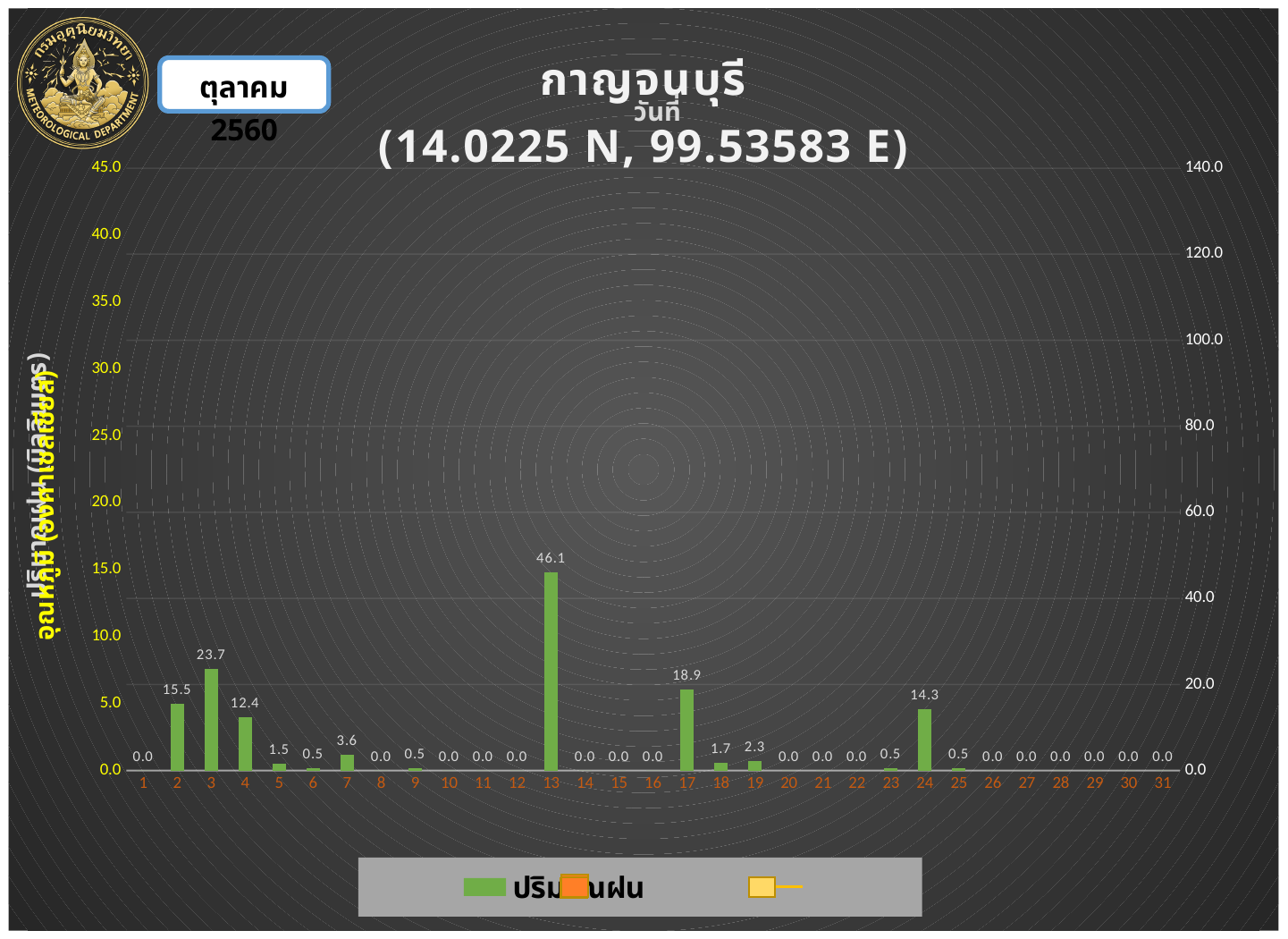
What is the rainfall value shown for day 13? 46.1 Is the value for day 13 greater or less than 40.0 on the right-hand axis? greater What kind of chart is used to show the rainfall values? bar chart What is the value labelled on the bar for day 3? 23.7 What station name appears in the chart title? กาญจนบุรี What is the difference between the values for day 13 and day 3? 22.4 Which has the larger value, day 2 or day 4? day 2 What is the difference between the values for day 17 and day 24? 4.6 What is the value labelled on the bar for day 17? 18.9 How many days are shown along the x axis? 31 Which day has the highest bar in the chart? 13 What is the value labelled on the bar for day 24? 14.3